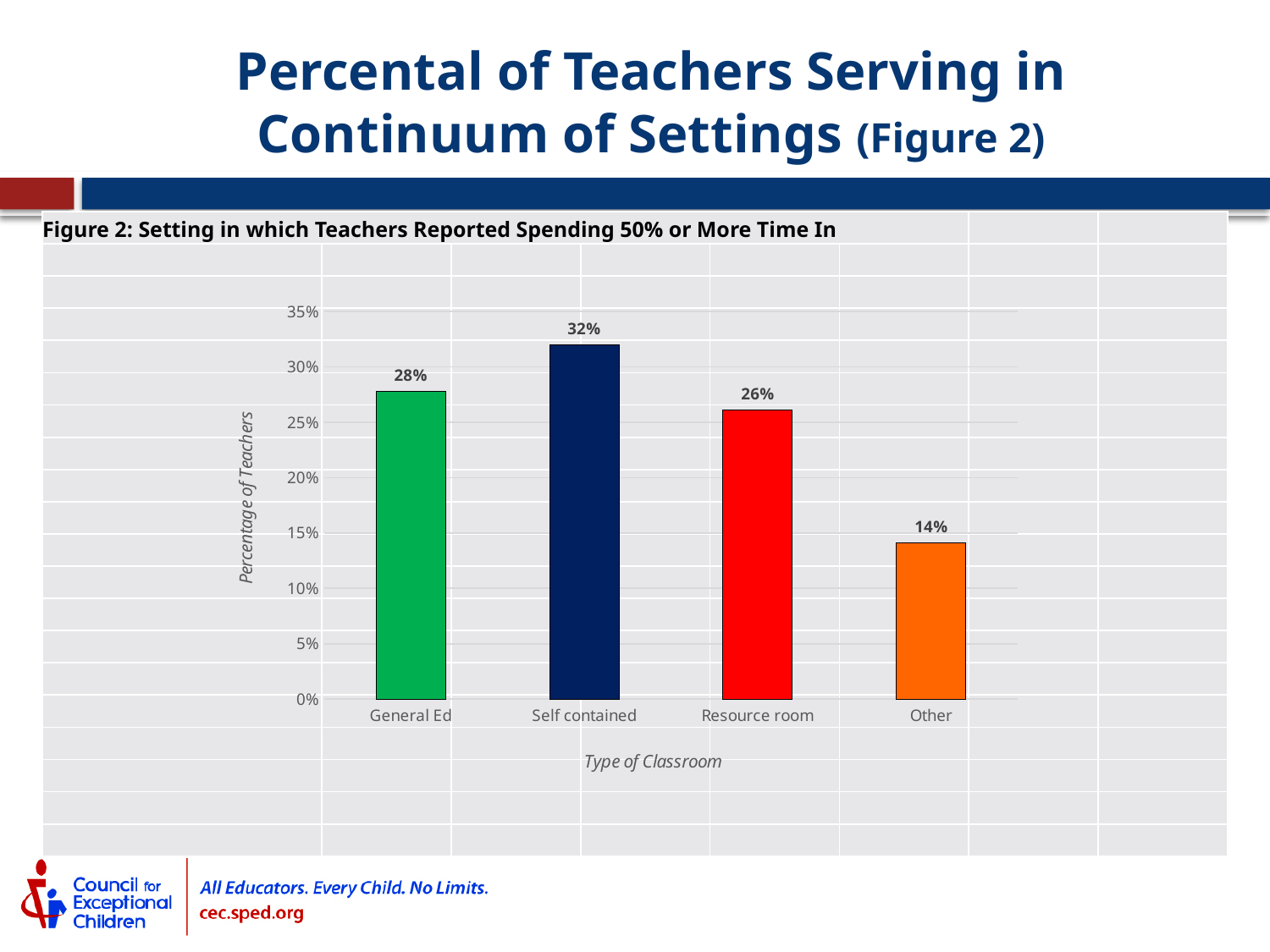
What is the difference in percentage points between Self contained and General Ed? 4 What is the label of the y axis? Percentage of Teachers How many types of classroom are shown on the x axis? 4 Which type of classroom has the lowest percentage of teachers? Other What kind of chart is shown on the slide? Bar chart What is the value for the Other category? 14% What percentage of teachers reported spending 50% or more time in a General Ed setting? 28% What is the value shown for Self contained? 32% Which is larger, the value for General Ed or the value for Resource room? General Ed Which type of classroom has the highest percentage of teachers? Self contained What percentage is shown for Resource room? 26% What is the difference in percentage points between Resource room and Other? 12